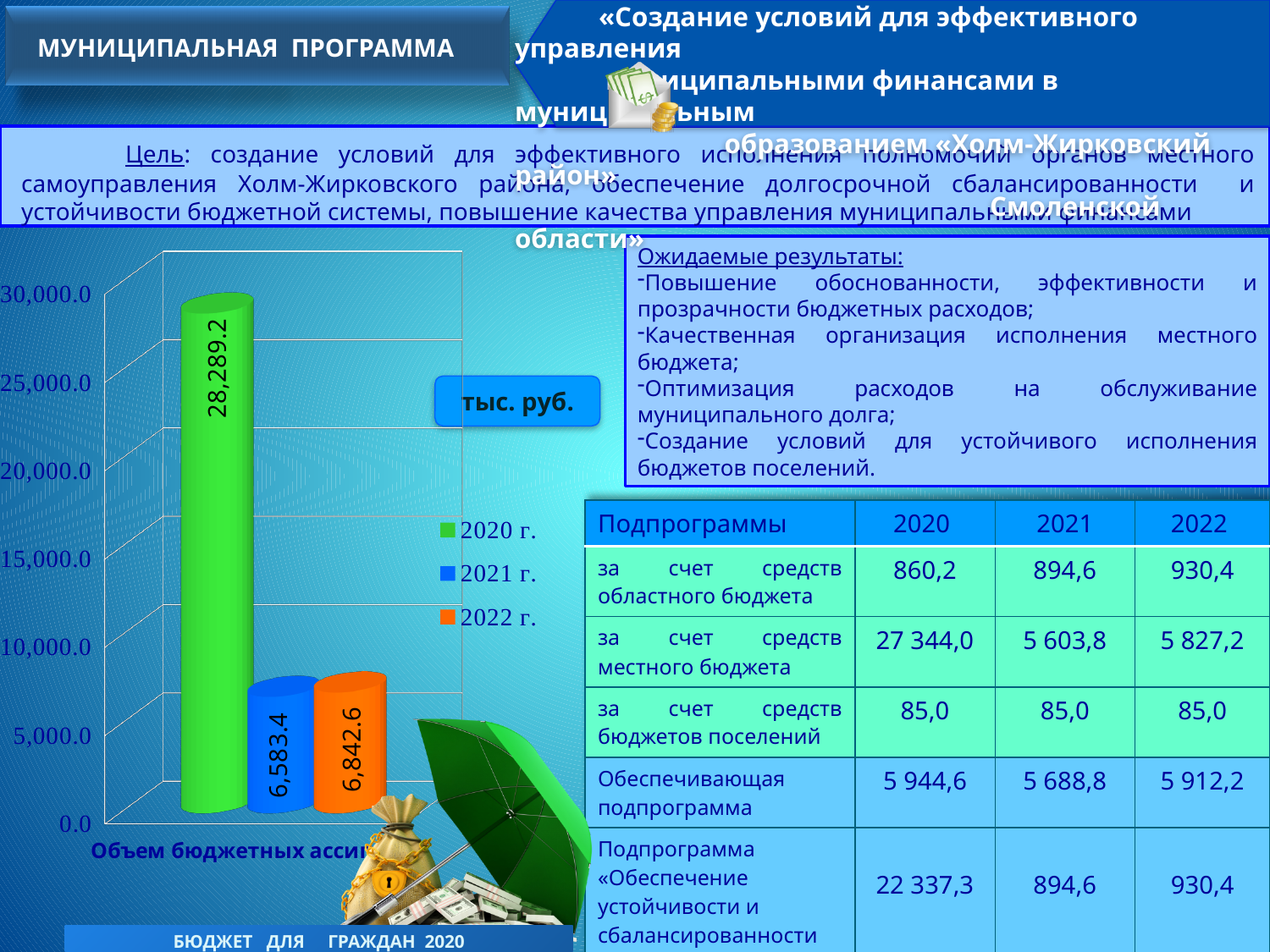
What is the value of the 2020 г. bar on the chart? 28,289.2 What is the value of the 2022 г. bar on the chart? 6,842.6 What unit is indicated for the chart values? тыс. руб. Which year has the highest bar on the chart? 2020 г. Is the value for 2020 г. greater or less than 25,000.0? greater What kind of chart is shown on the slide? bar chart What is the difference between the 2020 г. and 2022 г. values on the chart? 21,446.6 What is the difference between the 2022 г. and 2021 г. values on the chart? 259.2 Which year has the lowest bar on the chart? 2021 г. Which is larger on the chart, the 2021 г. value or the 2022 г. value? 2022 г. How many series does the chart legend list? 3 What is the value of the 2021 г. bar on the chart? 6,583.4